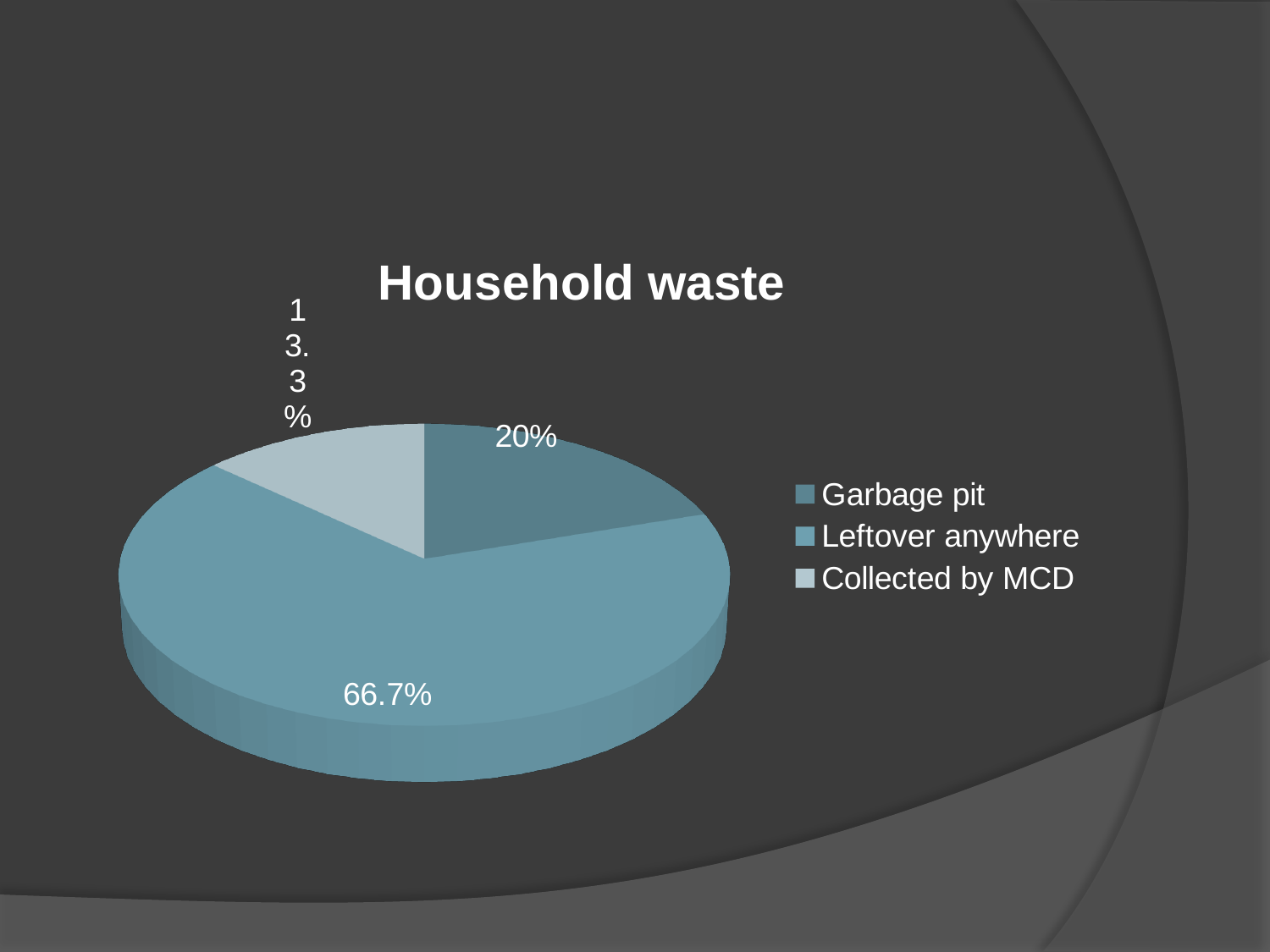
What percentage of household waste is labelled for Garbage pit? 20% What is the difference between the Garbage pit share and the Collected by MCD share? 6.7% What kind of chart is shown on the slide? Pie chart What is the title of the chart? Household waste What percentage of household waste is labelled for Leftover anywhere? 66.7% What percentage of household waste is labelled for Collected by MCD? 13.3% What is the difference between the Leftover anywhere share and the Garbage pit share? 46.7% Which legend entry is shown in the lightest colour? Collected by MCD Which category has the smallest share of the pie? Collected by MCD How many categories does the legend list? 3 Which category has the largest share of the pie? Leftover anywhere Which is larger, the share for Garbage pit or the share for Collected by MCD? Garbage pit